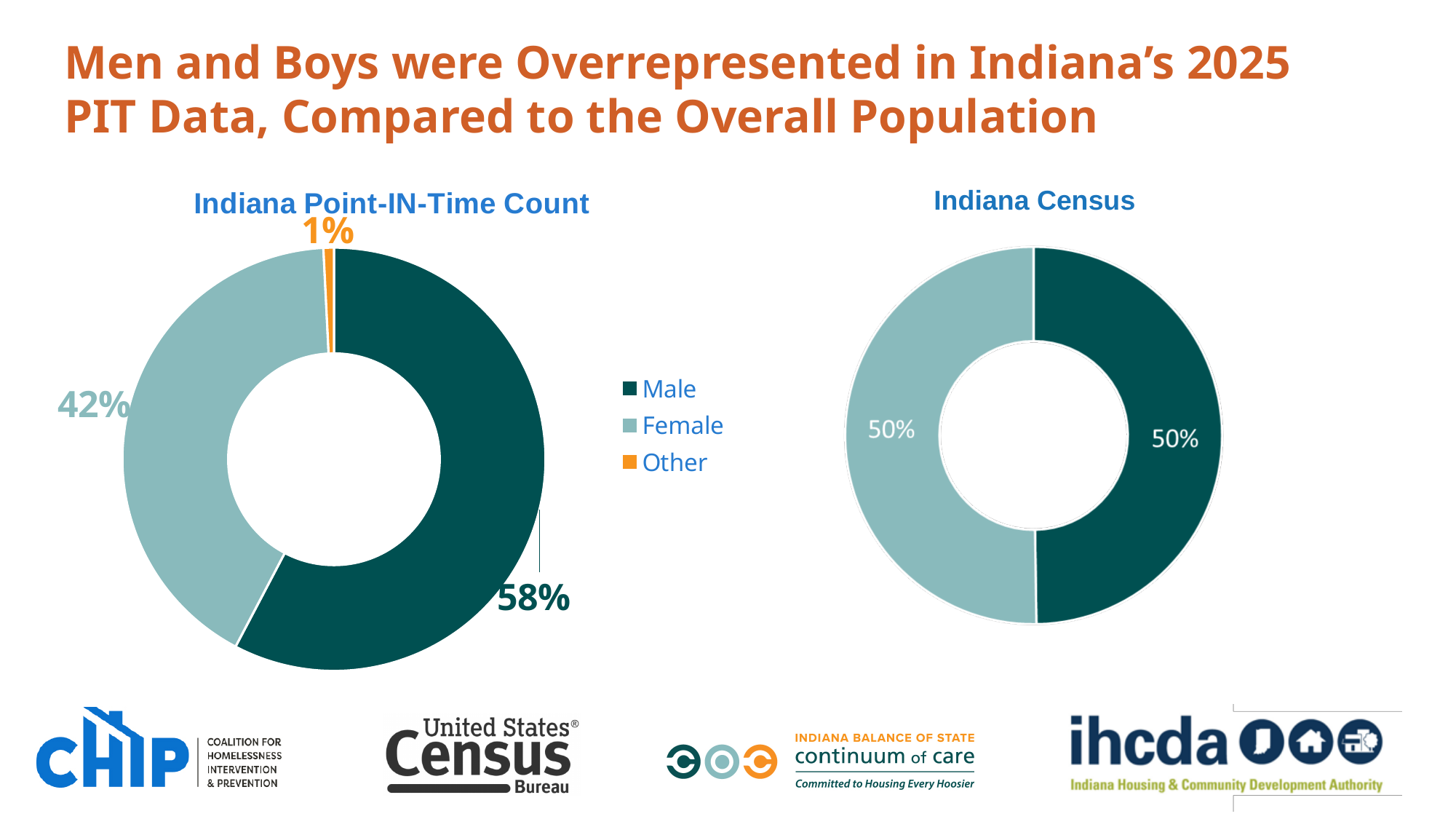
In the Indiana Point-IN-Time Count chart, which category has the smallest share? Other In the Indiana Point-IN-Time Count chart, what share is Male? 58% How many categories does the legend list? 3 In the Indiana Point-IN-Time Count chart, which is larger, the Male share or the Female share? Male In the Indiana Point-IN-Time Count chart, what share is Other? 1% In the Indiana Census chart, what share is Male? 50% How many slices are shown in the Indiana Census chart? 2 In the Indiana Point-IN-Time Count chart, what share is Female? 42% What kind of chart is the Indiana Census chart? Doughnut chart In the Indiana Point-IN-Time Count chart, what is the difference in percentage points between the Male and Female shares? 16 What colour represents Other in the legend? Orange In the Indiana Point-IN-Time Count chart, which category has the largest share? Male